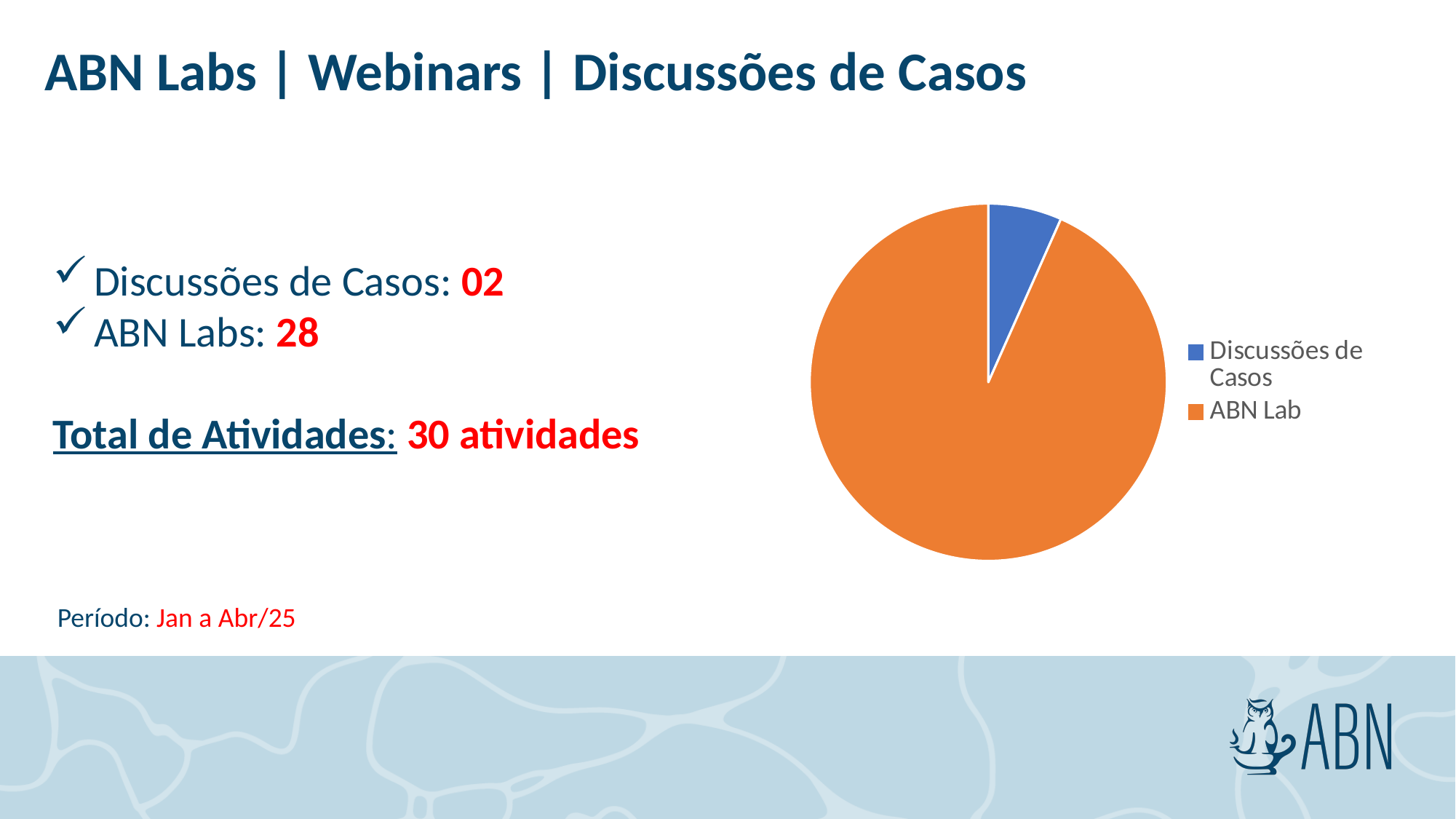
What is the total number of activities stated on the slide? 30 atividades Which slice of the pie chart is the largest? ABN Lab Which slice of the pie chart is the smallest? Discussões de Casos How many slices does the pie chart have? 2 What colour is the Discussões de Casos slice in the pie chart? blue According to the slide, how many Discussões de Casos activities are there? 02 According to the slide, how many ABN Labs activities are there? 28 What is the difference between the number of ABN Labs activities and Discussões de Casos activities? 26 Which is larger in the pie chart, ABN Lab or Discussões de Casos? ABN Lab What colour is the ABN Lab slice in the pie chart? orange What kind of chart is shown on the slide? pie chart How many entries does the legend of the pie chart list? 2